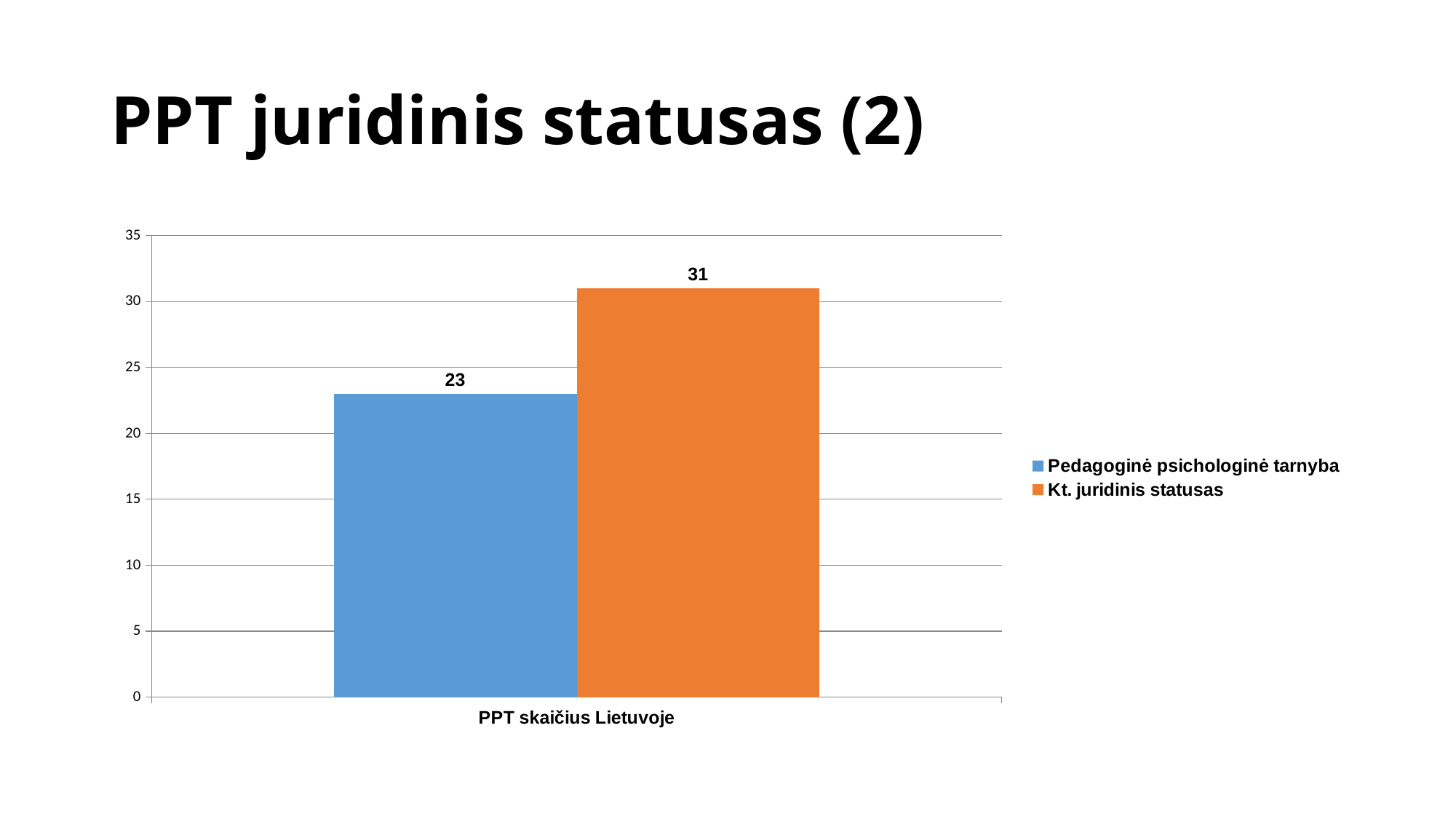
How many categories are shown on the x axis? 1 What is the value for Pedagoginė psichologinė tarnyba? 23 Which series has the higher value? Kt. juridinis statusas Is the value for Kt. juridinis statusas greater or less than 30? greater What is the label of the category on the x axis? PPT skaičius Lietuvoje How many series does the legend list? 2 Which series has the lower value? Pedagoginė psichologinė tarnyba What is the value for Kt. juridinis statusas? 31 Is the value for Pedagoginė psichologinė tarnyba greater or less than 25? less What kind of chart is shown on the slide? bar chart Is the value for Pedagoginė psichologinė tarnyba larger or smaller than the value for Kt. juridinis statusas? smaller What is the difference between the values for Kt. juridinis statusas and Pedagoginė psichologinė tarnyba? 8